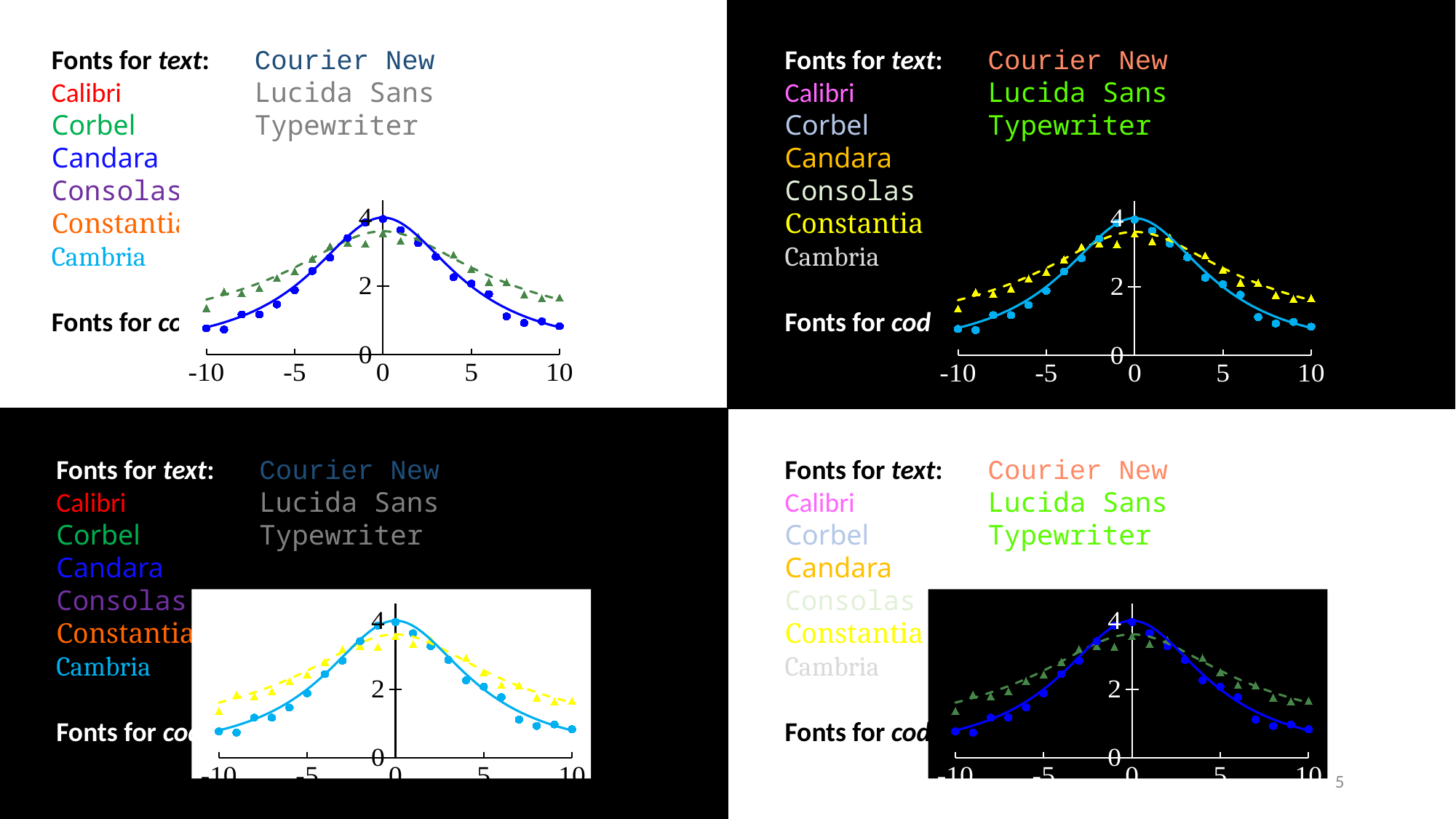
In the top-right chart, do the values of the cyan circle series rise or fall as x goes from 0 to 10? fall In the bottom-left chart, is the value of the yellow triangle series at x = 0 greater or less than 2? greater In the top-left chart, is the value of the blue circle series at x = 10 greater or less than 2? less How many data series are plotted in the bottom-right chart? 4 In the top-left chart, which series is higher at x = 0, the blue circle series or the green triangle series? the blue circle series In the top-right chart, do the values of the cyan circle series rise or fall as x goes from -10 to 0? rise In the top-left chart, which series is higher at x = -10, the blue circle series or the green triangle series? the green triangle series What is the highest tick label shown on the y axis of the top-left chart? 4 What kind of chart is shown in the top-left quadrant of the slide? line chart What is the range of the x axis shown in the bottom-left chart? -10 to 10 In the bottom-right chart, which series is higher at x = 10, the blue circle series or the green triangle series? the green triangle series In the top-left chart, is the value of the blue circle series at x = 0 greater or less than 2? greater